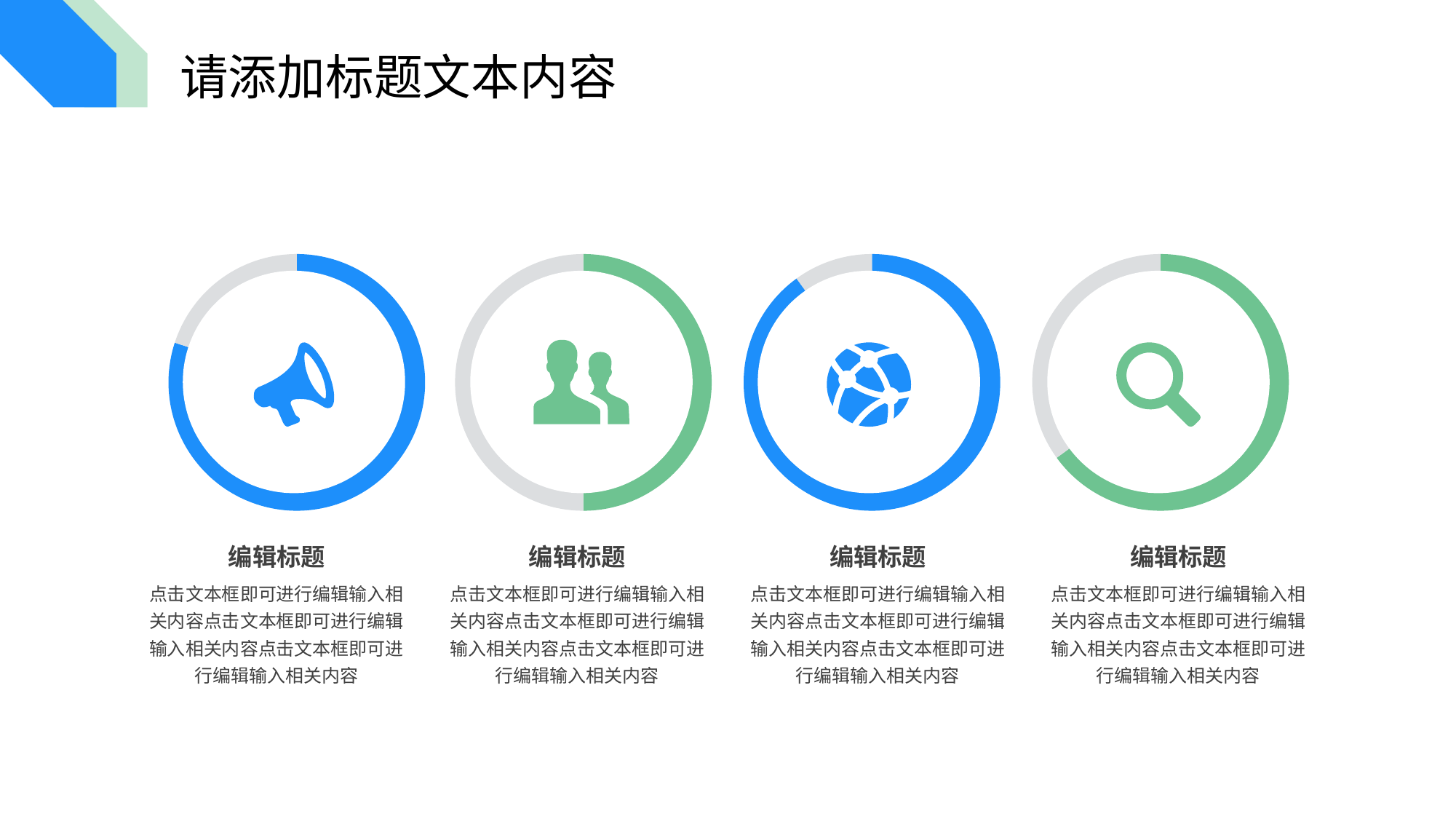
Which doughnut chart, counting from the left, has the largest coloured (filled) portion? The third Which doughnut chart, counting from the left, has the smallest coloured (filled) portion? The second Is the coloured portion larger in the first doughnut chart or in the second doughnut chart from the left? The first What colour is the filled portion of the fourth doughnut chart from the left? Green What colour is the filled portion of the first doughnut chart from the left? Blue Is the coloured portion larger in the second doughnut chart or in the third doughnut chart from the left? The third How many doughnut charts are on the slide? 4 Is the coloured portion larger in the third doughnut chart or in the fourth doughnut chart from the left? The third What kind of chart is shown in each of the four circles on the slide? Doughnut chart